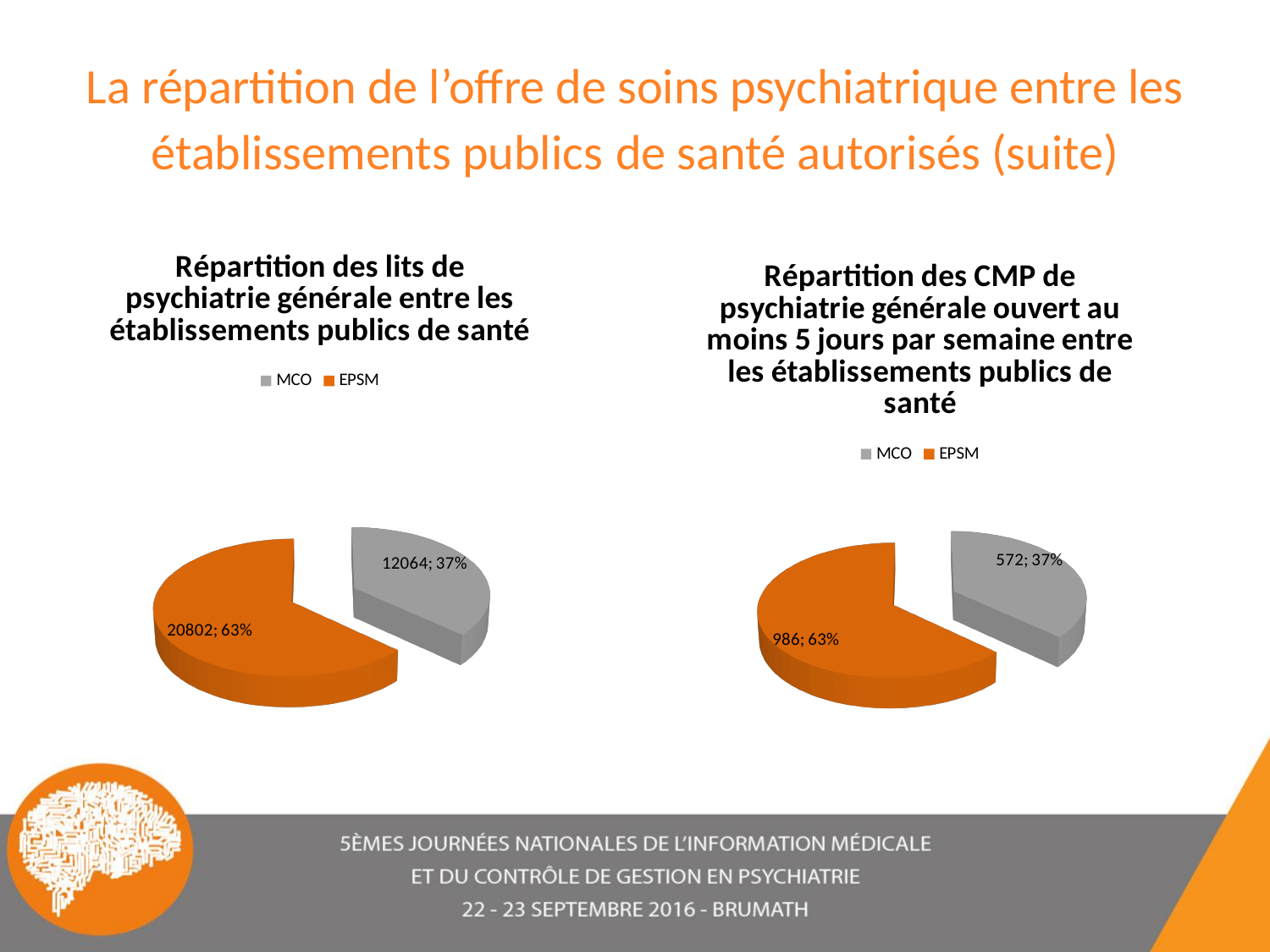
In the right chart (CMP de psychiatrie générale), what is the value for EPSM? 986 In the left chart (lits de psychiatrie générale), what is the difference between the EPSM and MCO values? 8738 What kind of chart is the left chart, 'Répartition des lits de psychiatrie générale entre les établissements publics de santé'? Pie chart In the left chart (lits de psychiatrie générale), what is the value for MCO? 12064 In the right chart (CMP de psychiatrie générale), how many slices does the pie have? 2 In the right chart (CMP de psychiatrie générale), which category has the smallest slice? MCO In the right chart (CMP de psychiatrie générale), what share of the pie does MCO represent? 37% In the left chart (lits de psychiatrie générale), what share of the pie does EPSM represent? 63% In the left chart (lits de psychiatrie générale), which colour represents EPSM in the legend? Orange In the left chart (lits de psychiatrie générale), what is the value for EPSM? 20802 In the left chart (lits de psychiatrie générale), which category has the largest slice? EPSM In the right chart (CMP de psychiatrie générale), what is the value for MCO? 572